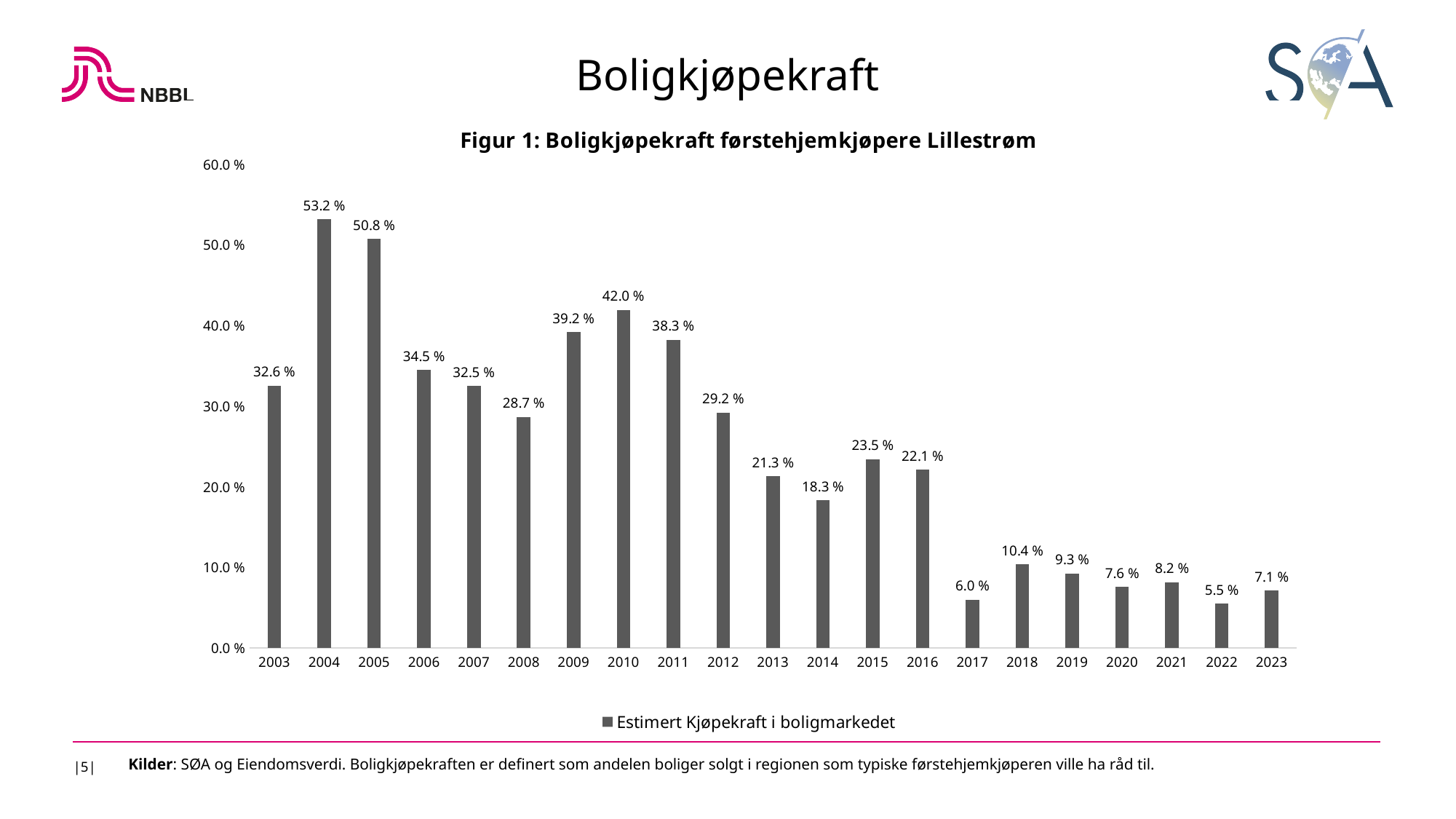
How many years are shown on the x axis? 21 What kind of chart is this? bar chart What is the value for 2023? 7.1 % What is the value for 2004? 53.2 % What is the value for 2017? 6.0 % Is the value for 2012 greater or less than 30.0 %? less Which year has the highest value? 2004 What is the difference between the values for 2010 and 2011? 3.7 % Which year has the lowest value? 2022 Which is larger, the value for 2015 or the value for 2016? 2015 What is the difference between the values for 2004 and 2023? 46.1 % Do the values generally rise or fall from 2003 to 2023? fall